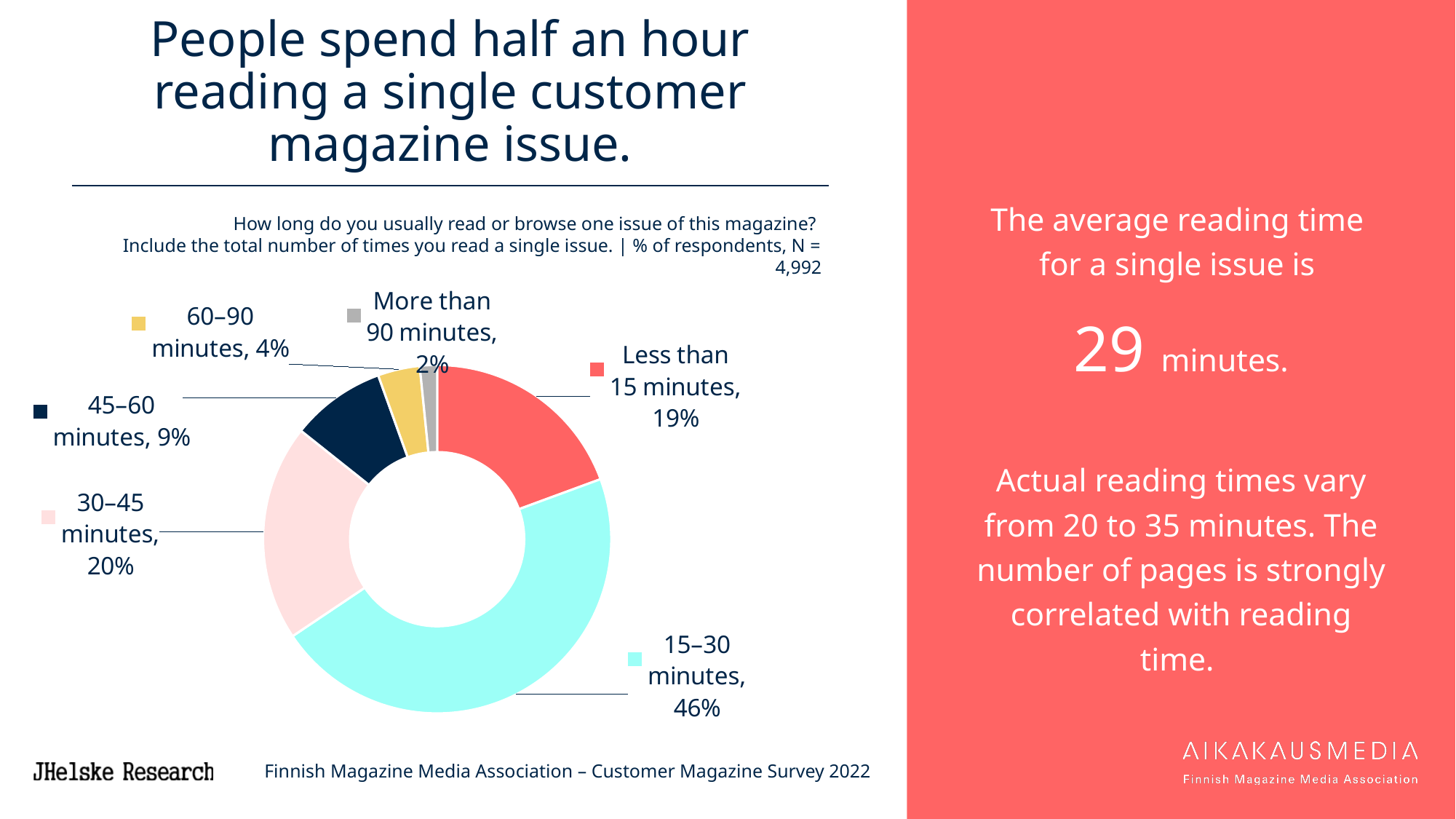
What is the difference in percentage points between the 15–30 minutes and 30–45 minutes categories? 26 What is the combined share of respondents who read for 45–60 minutes and 60–90 minutes? 13% How many reading-time categories are shown in the chart? 6 Which category has a larger share: 45–60 minutes or 60–90 minutes? 45–60 minutes Which reading-time category has the largest share of respondents? 15–30 minutes What percentage of respondents read a single issue for less than 15 minutes? 19% What percentage of respondents read a single issue for 15–30 minutes? 46% What is the sample size (N) stated in the chart subtitle? 4,992 What percentage of respondents read a single issue for more than 90 minutes? 2% What percentage of respondents read a single issue for 30–45 minutes? 20% What type of chart is used to show the reading-time distribution? Pie chart (doughnut) Which reading-time category has the smallest share of respondents? More than 90 minutes